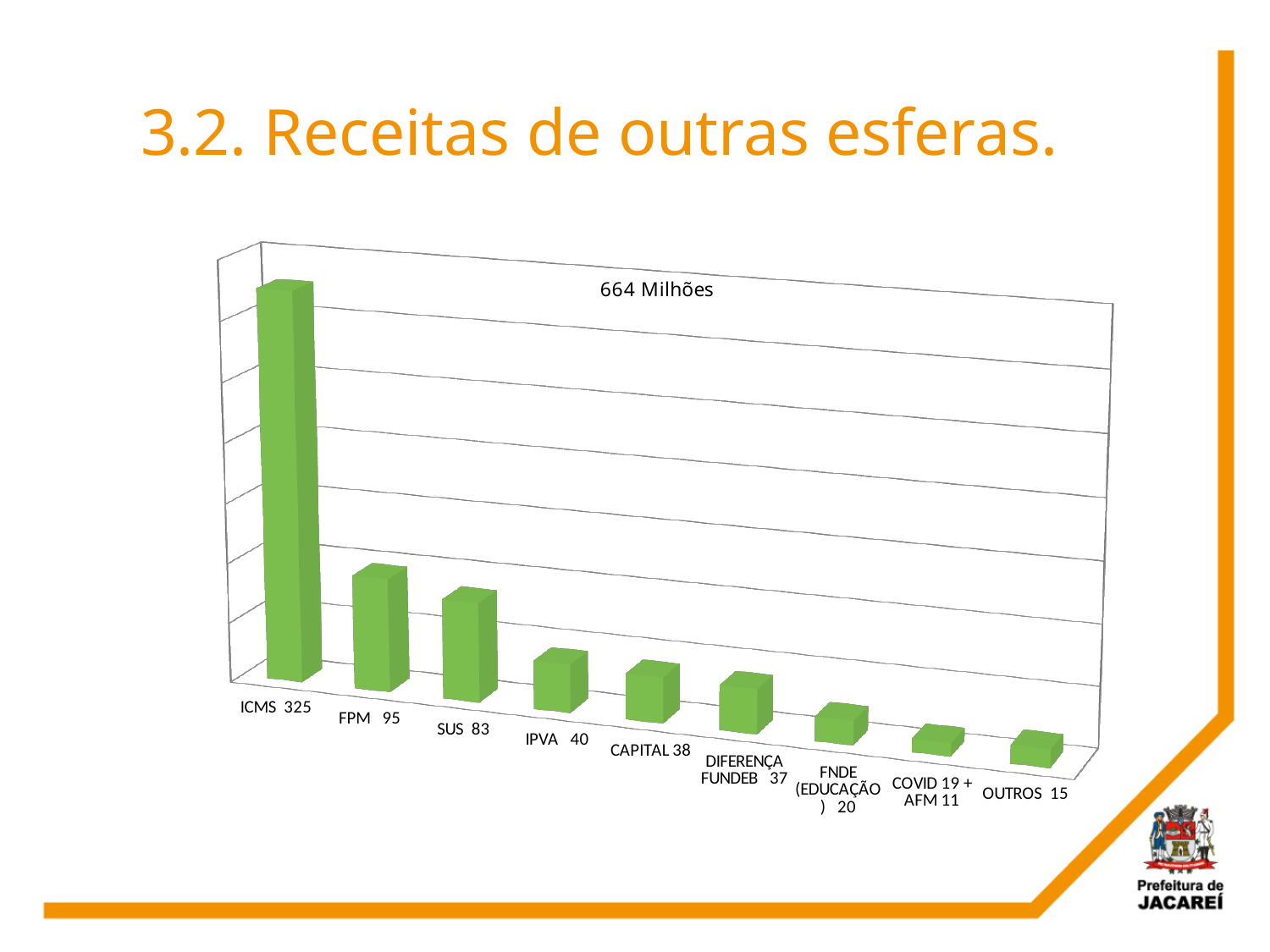
Which category has the lowest value? COVID 19 + AFM Which category has the highest value? ICMS What is the value for ICMS? 325 How many categories are shown in the chart? 9 Which is larger, the value for FPM or the value for SUS? FPM What is the difference between the values for SUS and IPVA? 43 What is the title shown on the chart? 664 Milhões What is the value for DIFERENÇA FUNDEB? 37 What kind of chart is shown on the slide? Bar chart What is the value for FPM? 95 What is the difference between the values for ICMS and FPM? 230 What is the value for COVID 19 + AFM? 11